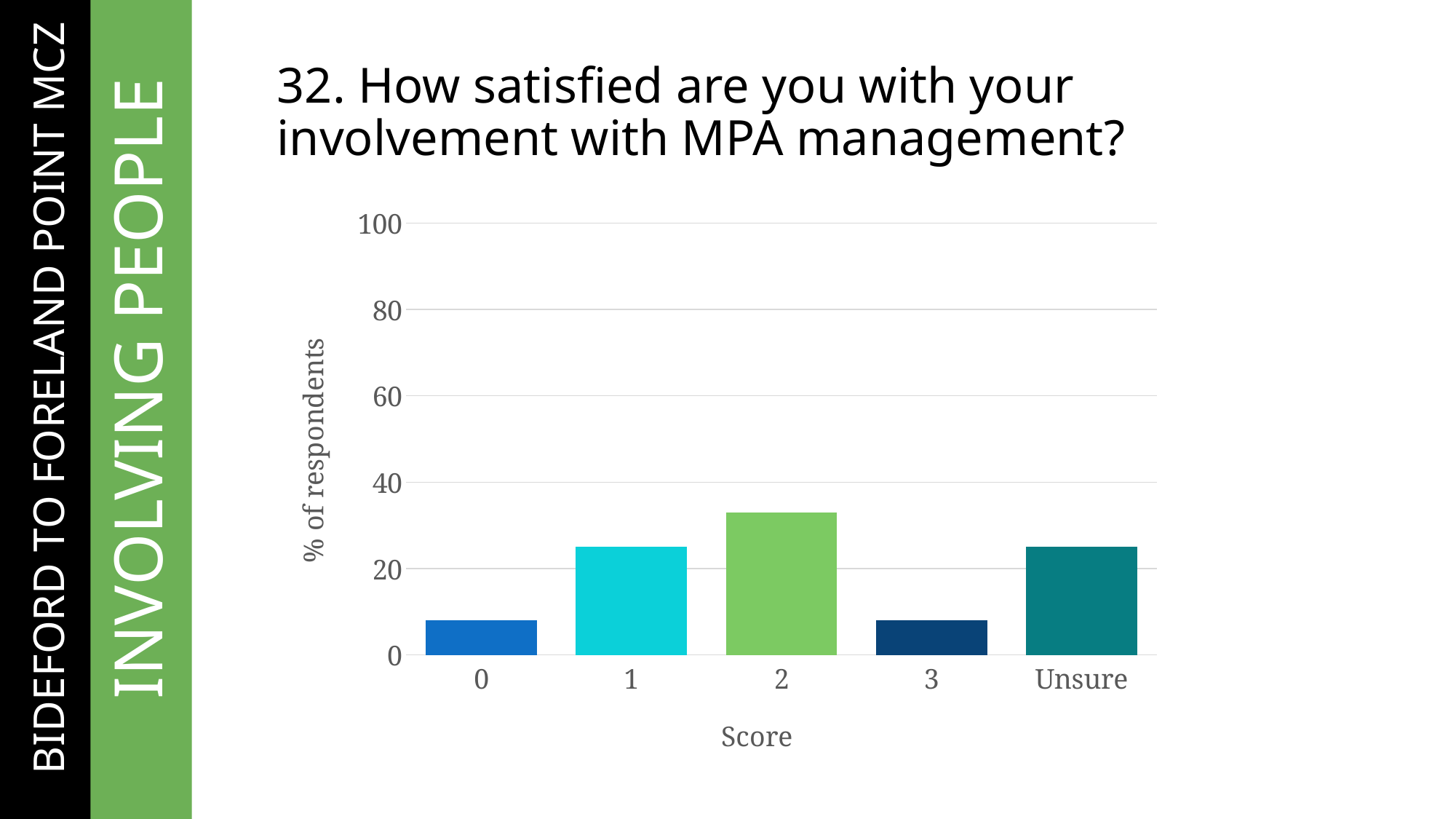
What kind of chart is shown on the slide? bar chart Is the value for score 0 greater or less than 20? less Is the value for score 3 greater or less than 20? less How many score categories are shown on the x axis? 5 Which has a higher percentage of respondents, score 1 or score 2? 2 Is the value for score 2 greater or less than 40? less Which score category has the highest percentage of respondents? 2 Which has a higher percentage of respondents, score 0 or score 1? 1 What is the label of the x axis? Score What is the label of the y axis? % of respondents